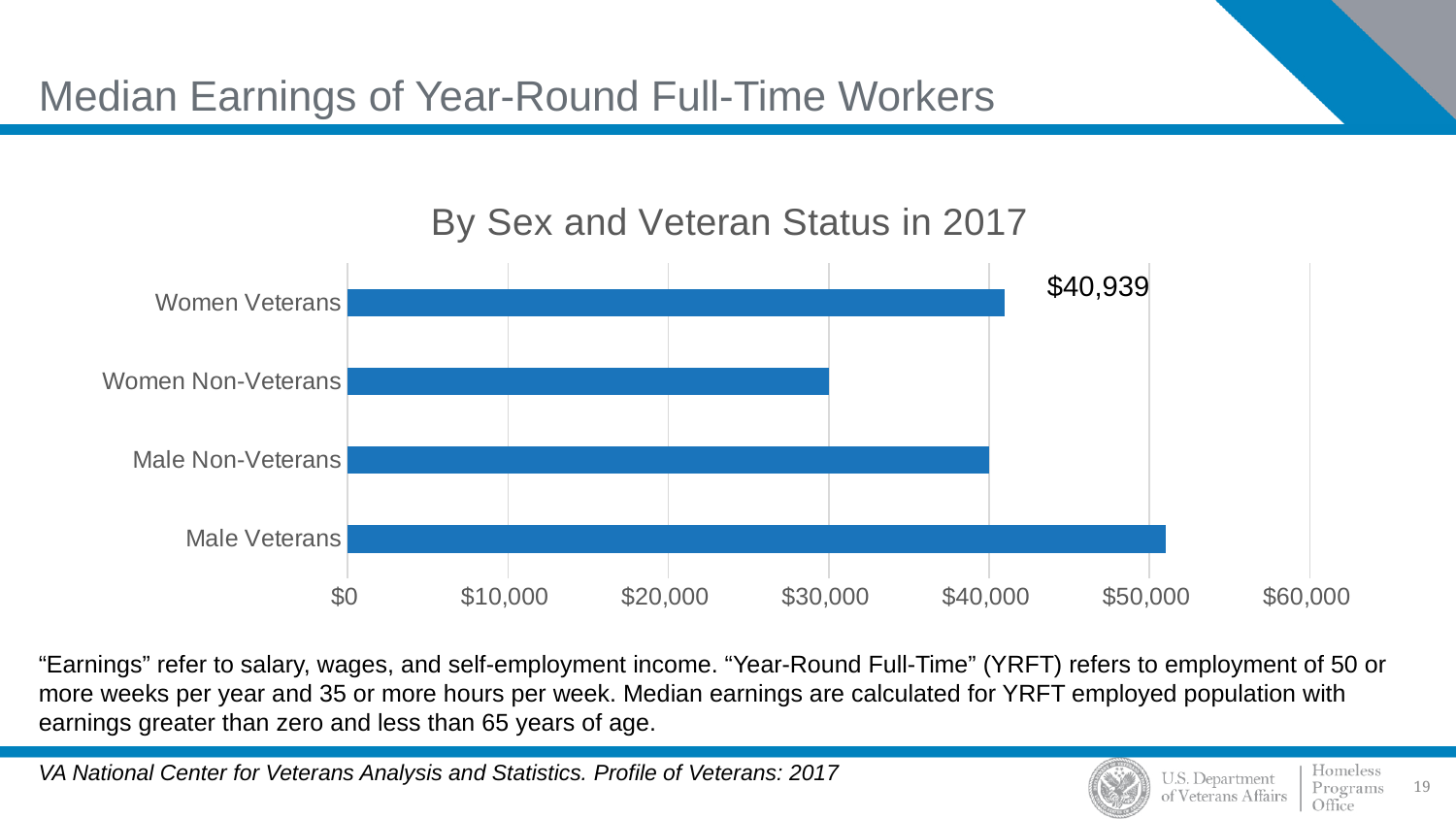
What is the highest value labeled on the x axis? $60,000 Is the value for Male Non-Veterans greater or less than $30,000? greater What kind of chart is shown on the slide? Bar chart Is the value for Women Non-Veterans greater or less than $40,000? less What is the median earnings value shown for Women Veterans? $40,939 What is the title of the chart? By Sex and Veteran Status in 2017 How many categories are shown in the chart? 4 Is the value for Male Veterans greater or less than $40,000? greater Which category has the highest median earnings? Male Veterans Which category has the lowest median earnings? Women Non-Veterans Which has higher median earnings, Women Veterans or Women Non-Veterans? Women Veterans Which has higher median earnings, Male Veterans or Women Veterans? Male Veterans